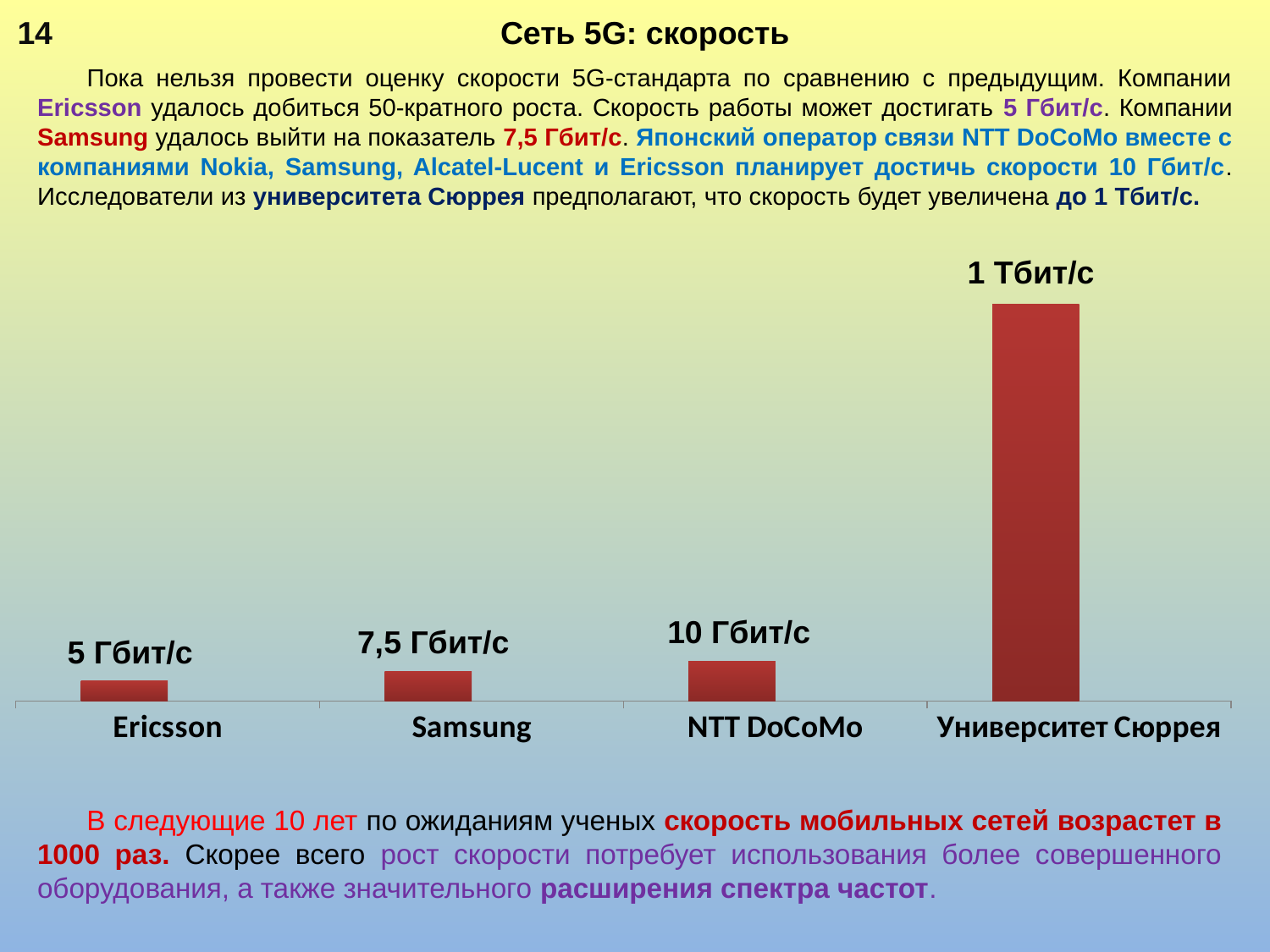
Which category has the lowest bar in the chart? Ericsson What value is shown for Университет Сюррея in the chart? 1 Тбит/с Which category has the highest bar in the chart? Университет Сюррея What value is shown for NTT DoCoMo in the chart? 10 Гбит/с Which is larger, the value for Samsung or the value for NTT DoCoMo? NTT DoCoMo What kind of chart is shown on the slide? Bar chart What value is shown for Ericsson in the chart? 5 Гбит/с What is the difference between the values for Samsung and Ericsson? 2,5 Гбит/с What value is shown for Samsung in the chart? 7,5 Гбит/с Do the bar values rise or fall from left to right along the x axis? Rise What is the difference between the values for NTT DoCoMo and Ericsson? 5 Гбит/с How many categories are shown in the chart? 4